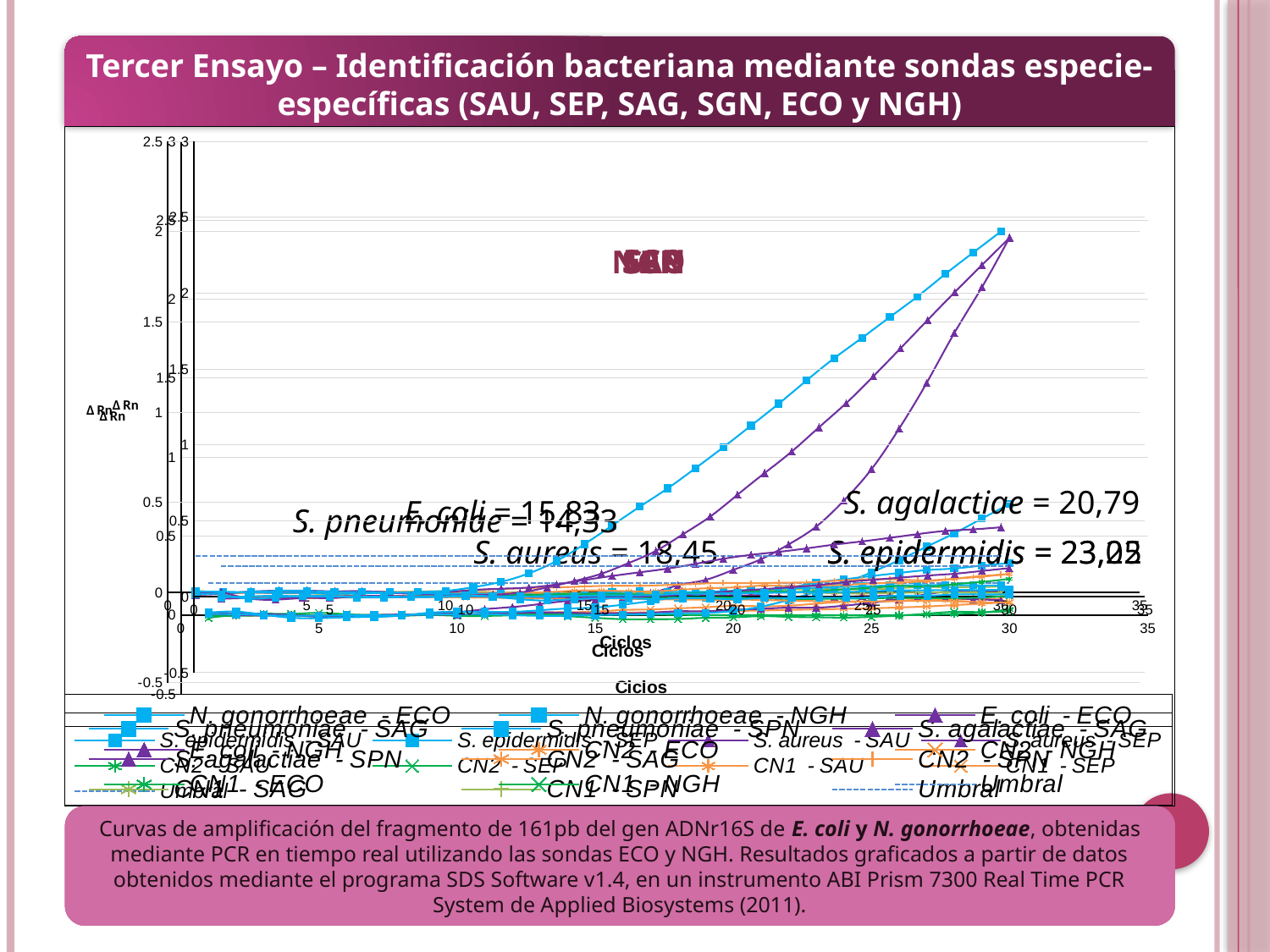
What is the difference between the annotated values for S. aureus and E. coli? 2,62 What value is annotated on the chart for S. pneumoniae? 14,33 What value is annotated on the chart for S. agalactiae? 20,79 What kind of chart is shown on the slide? line chart What is the label of the x axis of the chart? Ciclos Do the amplification curves rise or fall as the number of cycles increases along the x axis? rise What value is annotated on the chart for E. coli? 15,83 What value is annotated on the chart for S. aureus? 18,45 What is the highest tick value shown on the x axis of the chart? 35 Which annotated value is larger, the one for S. agalactiae or the one for S. aureus? S. agalactiae